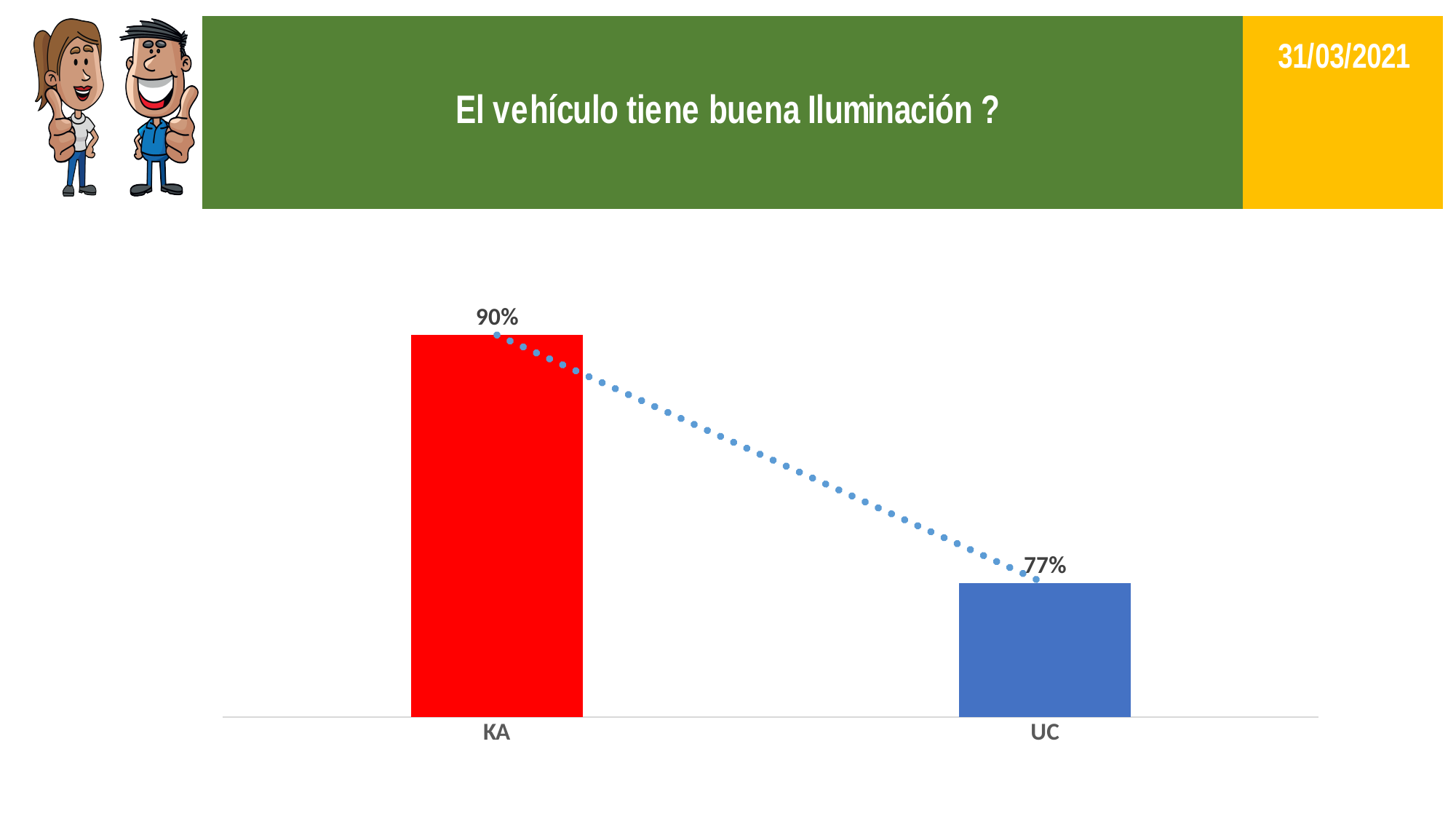
Which category has the lowest value? UC What colour is the bar for UC? blue What kind of chart is shown on the slide? bar chart Do the values rise or fall from KA to UC? fall What is the value for UC? 77% What is the difference between the values for KA and UC? 13% What colour is the bar for KA? red Which is larger, the value for KA or the value for UC? KA What is the value for KA? 90% How many categories are shown on the x axis? 2 Which category has the highest value? KA